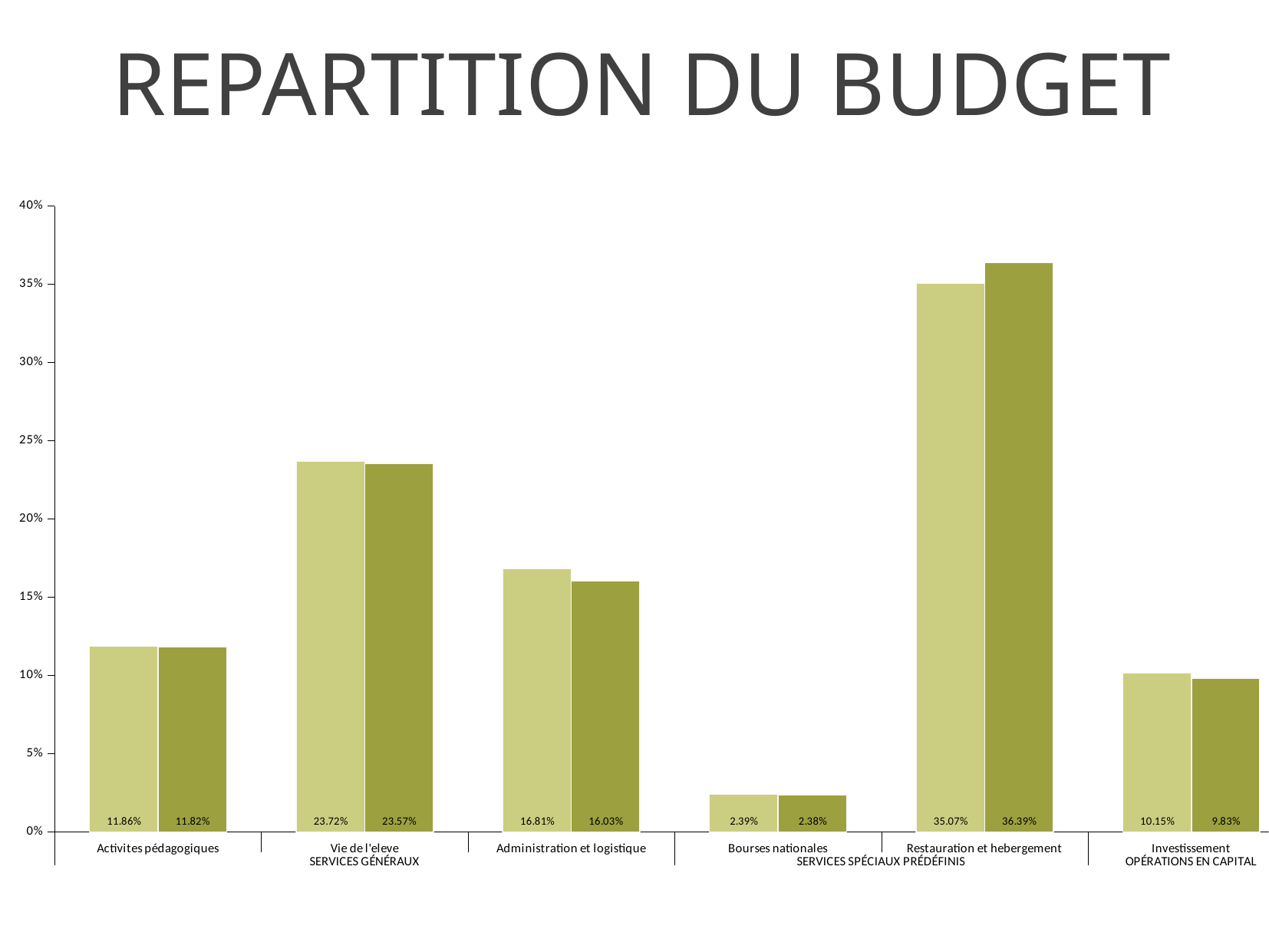
What is the value of the lighter green bar for Vie de l'eleve? 23.72% For Restauration et hebergement, which bar is larger, the lighter or the darker one? the darker one Which category has the lowest values in the chart? Bourses nationales What is the value of the darker green bar for Investissement? 9.83% Is the value of the darker bar for Vie de l'eleve greater or less than 25%? less What is the value of the darker green bar for Restauration et hebergement? 36.39% How many categories are shown on the x axis? 6 What is the difference between the darker and lighter bars for Restauration et hebergement? 1.32% Which category has the highest values in the chart? Restauration et hebergement What is the value of the lighter green bar for Bourses nationales? 2.39% What type of chart is shown on the slide? bar chart What is the difference between the lighter and darker bars for Administration et logistique? 0.78%